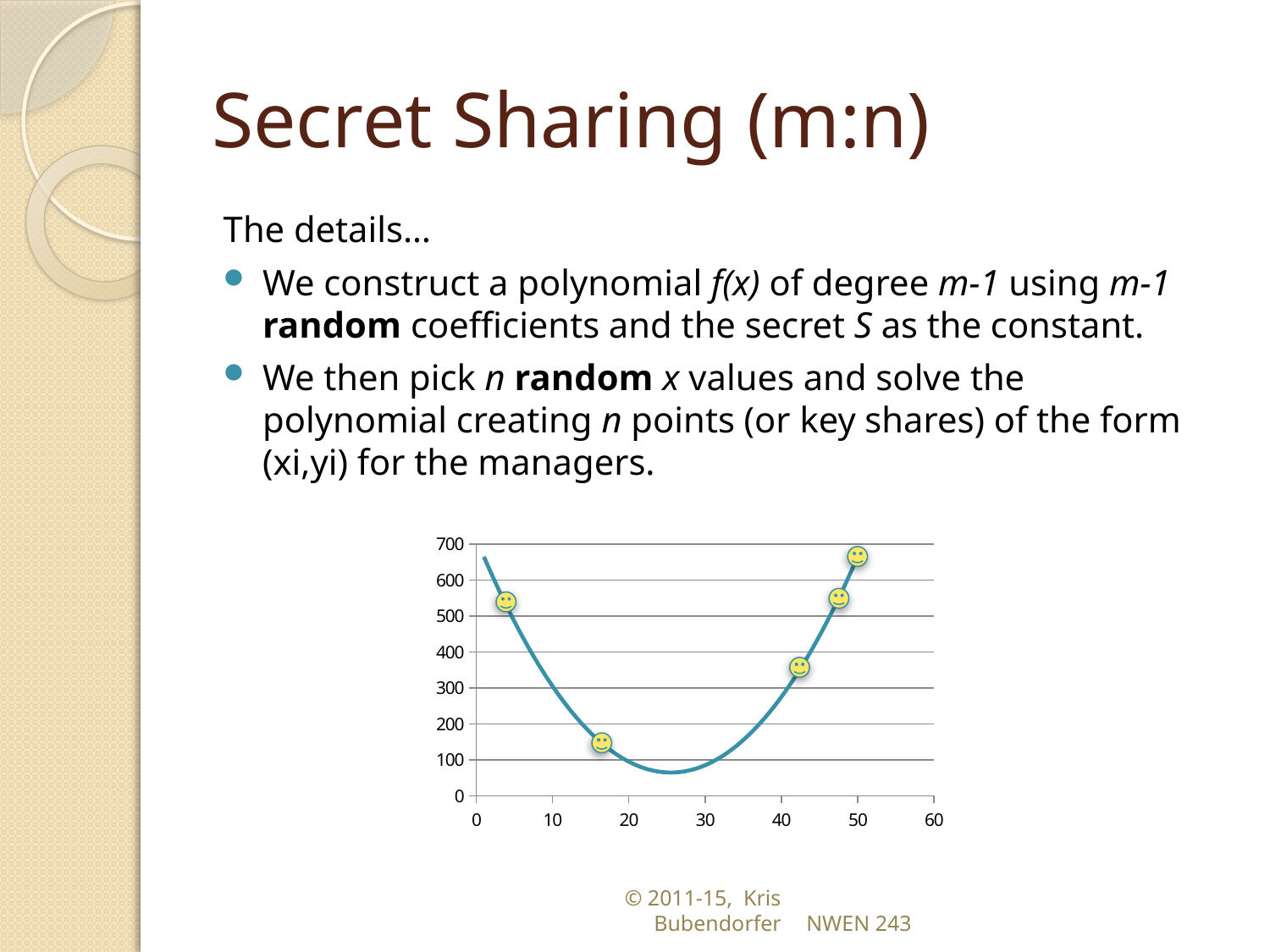
Moving left to right along the x axis, do the plotted values fall, rise, or fall and then rise? fall and then rise Which marked point has the highest y value: the one near x = 16 or the one near x = 50? the one near x = 50 Is the value of the leftmost marked point (near x = 4) greater or less than 500? greater Which of the marked points has the lowest y value? the one near x = 16 Is the value of the marked point near x = 50 greater or less than 600? greater What is the highest value shown on the y axis? 700 How many smiley-face marker points are plotted on the curve? 5 What is the highest value shown on the x axis? 60 Is the value of the marked point near x = 16 greater or less than 200? less What kind of chart is shown on the slide? line chart